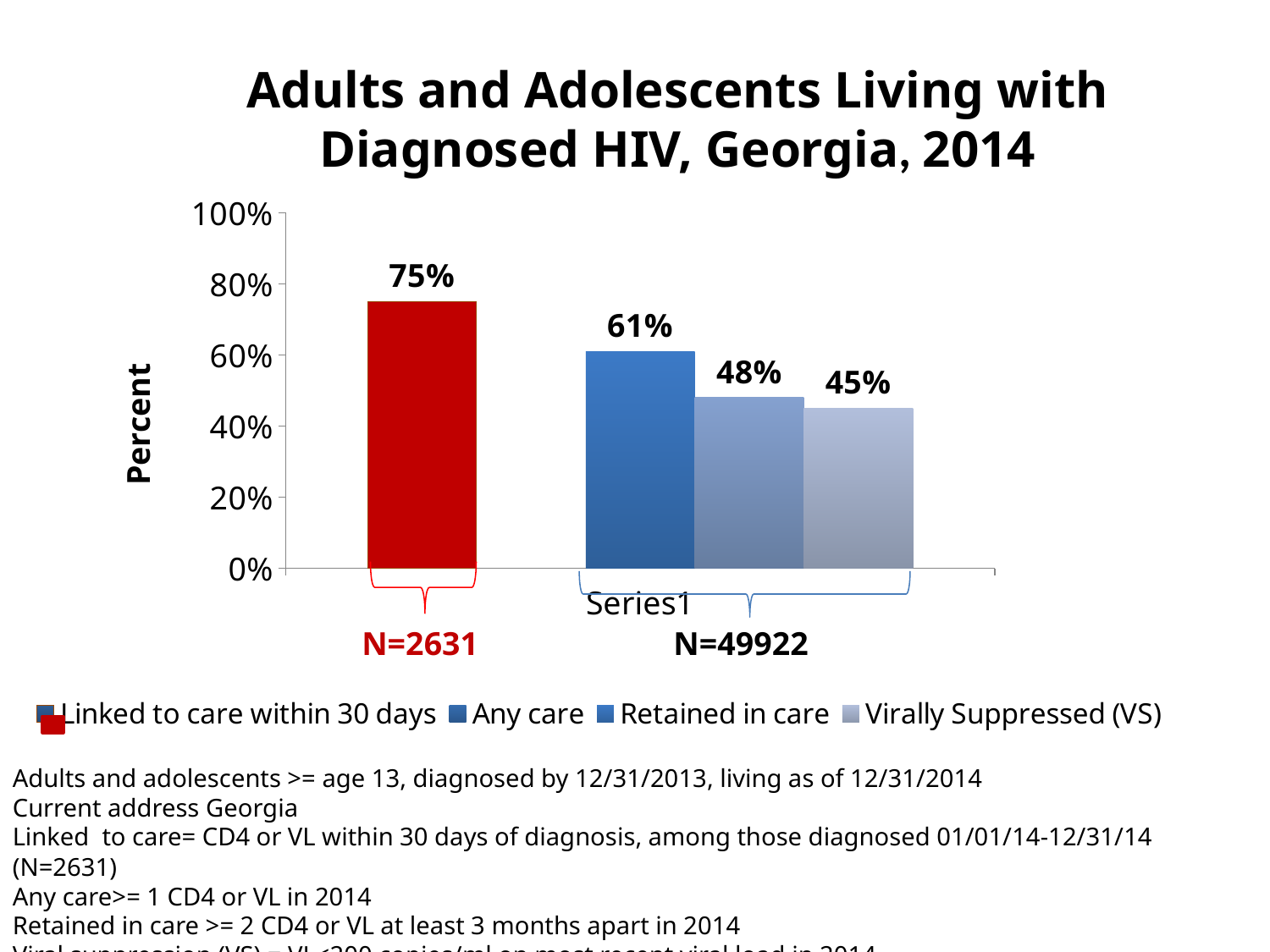
What is the value for Virally Suppressed (VS)? 45% What is the value for Linked to care within 30 days? 75% Which series has the highest value? Linked to care within 30 days What kind of chart is shown on the slide? Bar chart What is the value for Retained in care? 48% What is the difference between the Linked to care within 30 days value and the Virally Suppressed (VS) value? 30% Which series has the lowest value? Virally Suppressed (VS) What is the difference between the Any care value and the Retained in care value? 13% How many series does the legend list? 4 What is the title of the chart? Adults and Adolescents Living with Diagnosed HIV, Georgia, 2014 What is the value for Any care? 61% Which is larger, the value for Any care or the value for Retained in care? Any care